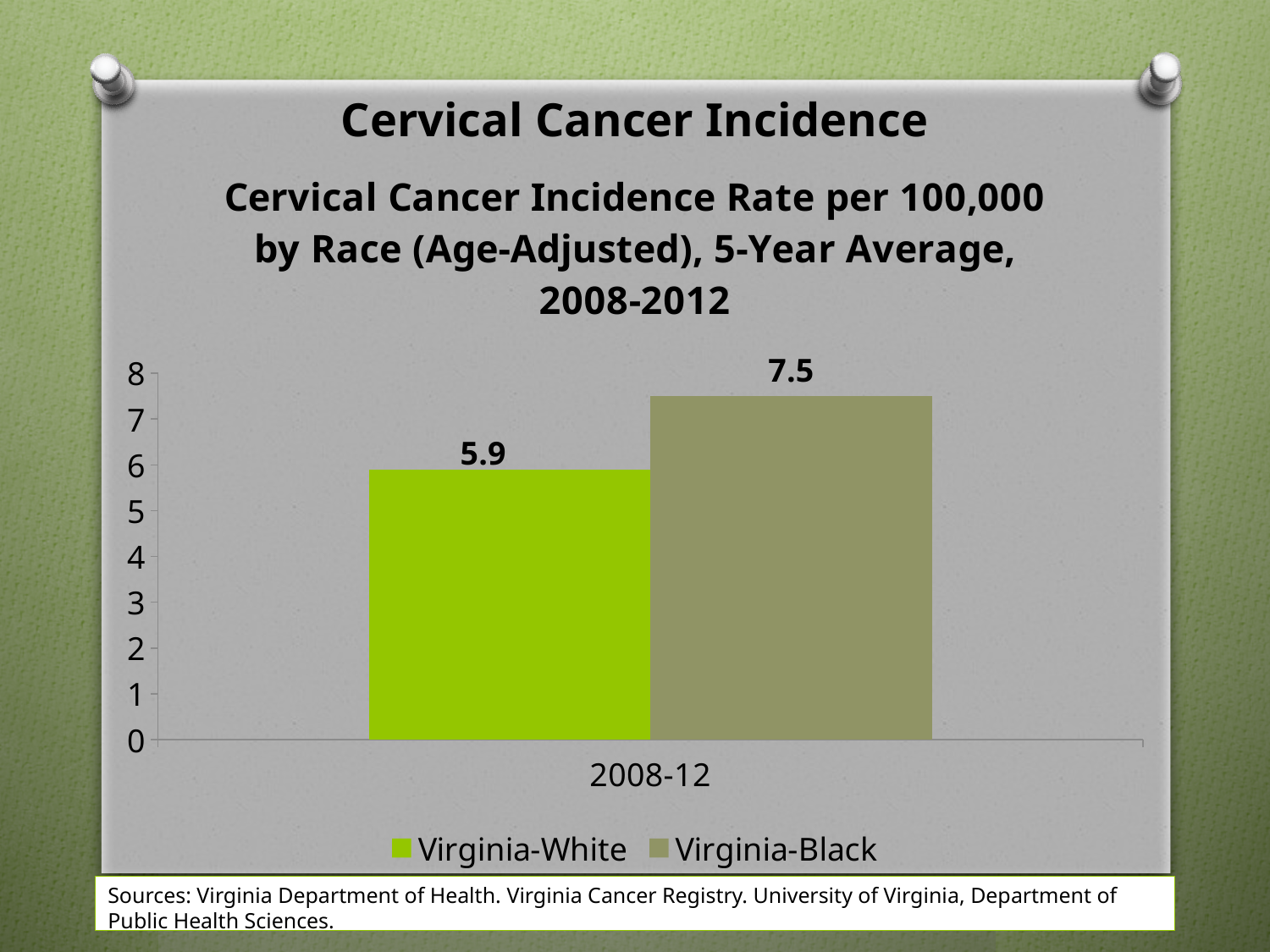
What is the cervical cancer incidence rate for Virginia-Black in 2008-12? 7.5 How many categories are shown on the x axis? 1 How many series does the legend list? 2 What is the maximum value shown on the y axis? 8 Which series has the lower cervical cancer incidence rate? Virginia-White What is the category label on the x axis? 2008-12 Which series has the higher cervical cancer incidence rate? Virginia-Black What kind of chart is shown on the slide? Bar chart What is the difference between the Virginia-Black and Virginia-White incidence rates? 1.6 Is the incidence rate for Virginia-White greater or less than 6? less Is the incidence rate for Virginia-Black greater or less than 7? greater What is the cervical cancer incidence rate for Virginia-White in 2008-12? 5.9